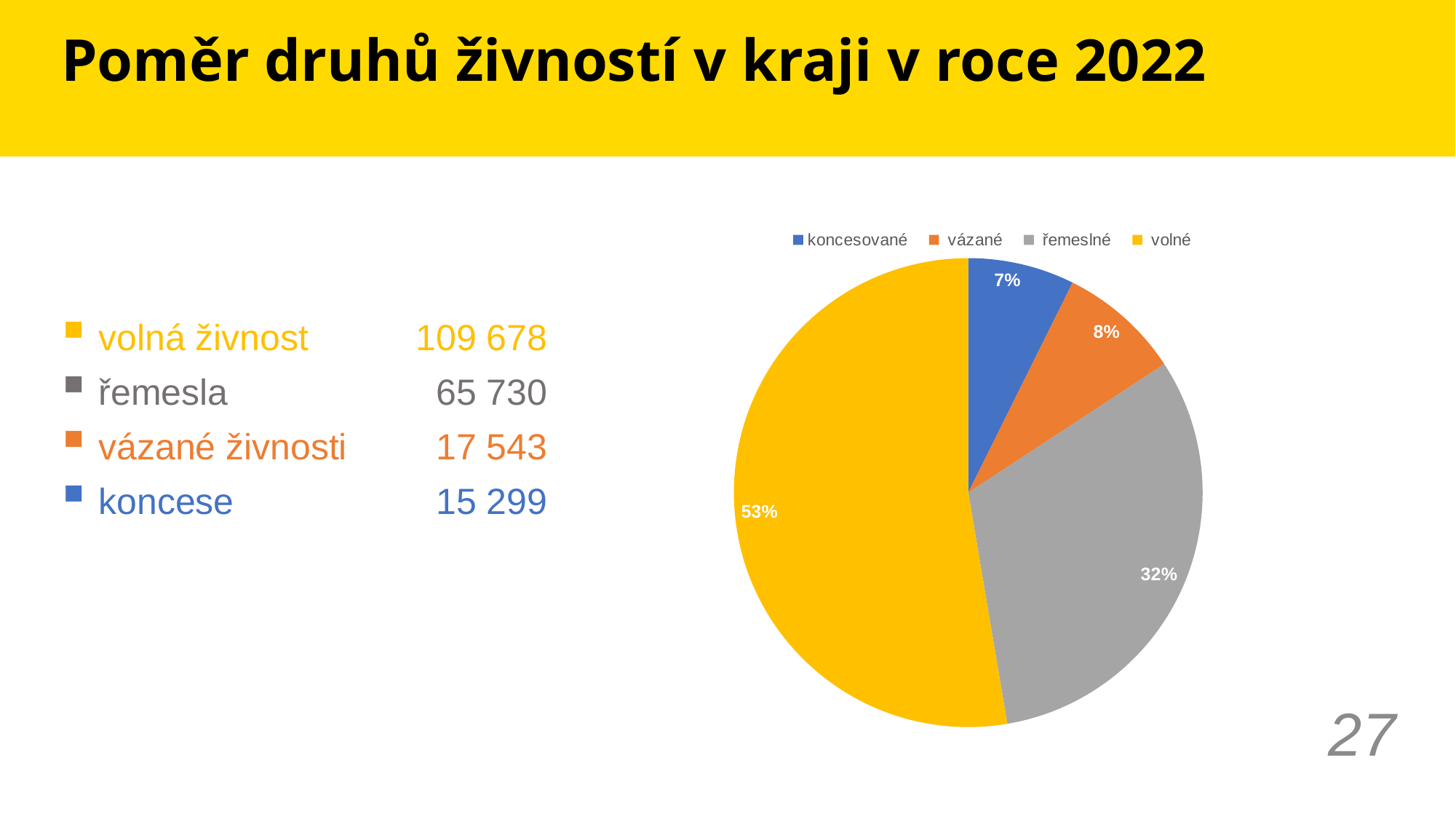
What is the difference in percentage points between the volné and řemeslné slices? 21 How many entries does the legend of the pie chart list? 4 How many slices does the pie chart have? 4 What colour is the volné slice in the pie chart? yellow Which slice of the pie chart is the largest? volné Which slice of the pie chart is the smallest? koncesované What share of the pie does the volné slice represent? 53% What kind of chart is shown on the slide? pie chart What share of the pie does the koncesované slice represent? 7% What share of the pie does the vázané slice represent? 8% Which slice is larger, řemeslné or vázané? řemeslné